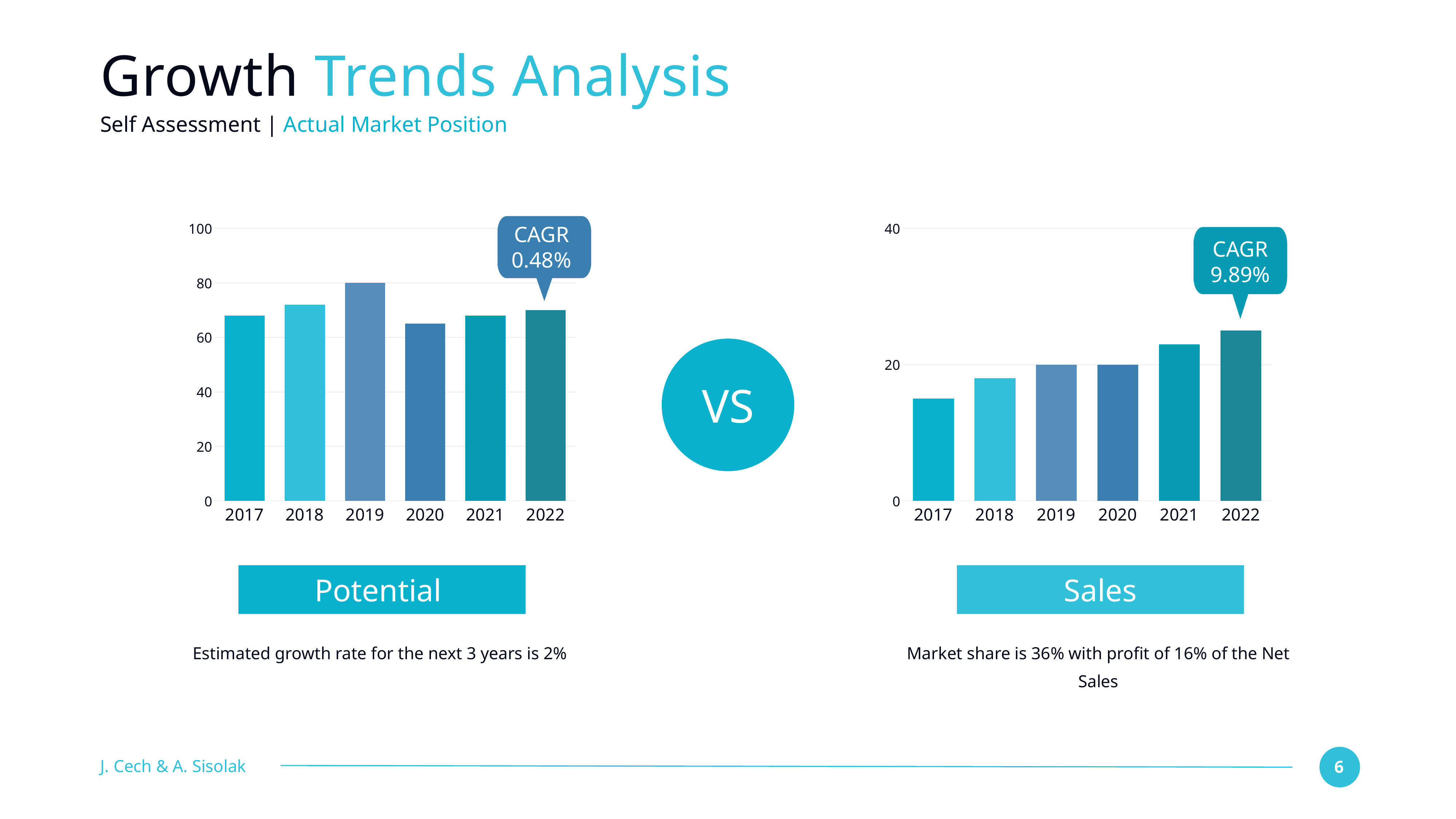
What kind of chart is the Potential chart on the left? bar chart In the Sales chart on the right, which year has the lowest bar? 2017 In the Potential chart on the left, is the value for 2017 greater or less than 60? greater How many years are shown on the x axis of the Sales chart on the right? 6 In the Sales chart on the right, which is larger, the value for 2018 or the value for 2021? 2021 What CAGR is shown in the callout on the Sales chart on the right? 9.89% In the Sales chart on the right, is the value for 2021 greater or less than 20? greater In the Potential chart on the left, is the value for 2022 greater or less than 80? less In the Potential chart on the left, which year has the highest bar? 2019 In the Sales chart on the right, do the values generally rise or fall from 2017 to 2022? rise In the Sales chart on the right, which year has the highest bar? 2022